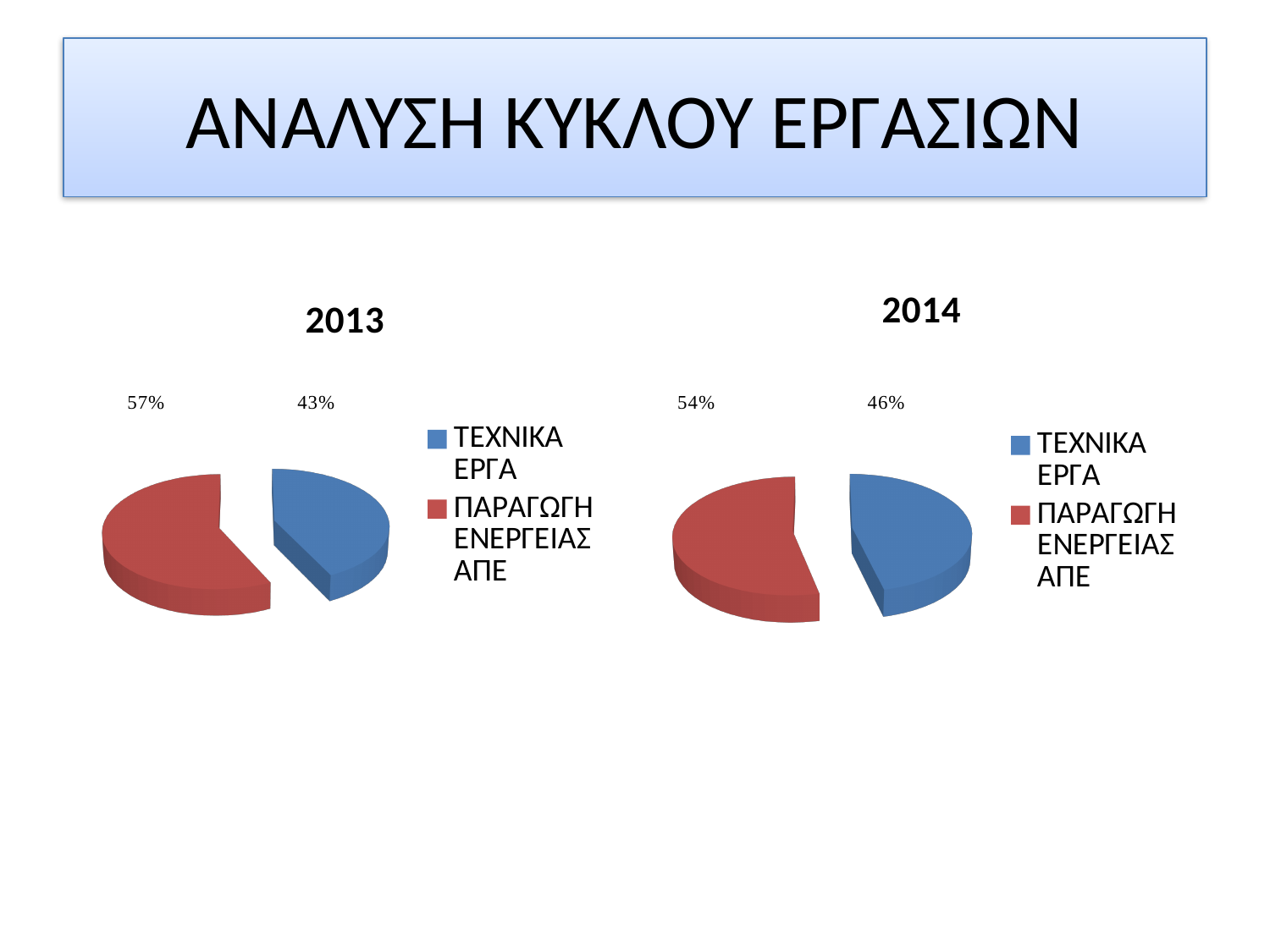
How many categories does the 2014 chart show? 2 In the 2014 chart, what colour is the ΠΑΡΑΓΩΓΗ ΕΝΕΡΓΕΙΑΣ ΑΠΕ slice? Red In the 2013 chart, which category has the largest slice? ΠΑΡΑΓΩΓΗ ΕΝΕΡΓΕΙΑΣ ΑΠΕ In the 2014 chart, which category has the smallest slice? ΤΕΧΝΙΚΑ ΕΡΓΑ In the 2013 chart, what share does ΤΕΧΝΙΚΑ ΕΡΓΑ have? 43% In the 2013 chart, what share does ΠΑΡΑΓΩΓΗ ΕΝΕΡΓΕΙΑΣ ΑΠΕ have? 57% In the 2014 chart, what share does ΠΑΡΑΓΩΓΗ ΕΝΕΡΓΕΙΑΣ ΑΠΕ have? 54% What kind of chart is the 2013 chart? Pie chart In the 2013 chart, what is the difference between the ΠΑΡΑΓΩΓΗ ΕΝΕΡΓΕΙΑΣ ΑΠΕ share and the ΤΕΧΝΙΚΑ ΕΡΓΑ share? 14% In the 2014 chart, what is the difference between the ΠΑΡΑΓΩΓΗ ΕΝΕΡΓΕΙΑΣ ΑΠΕ share and the ΤΕΧΝΙΚΑ ΕΡΓΑ share? 8% Is the ΤΕΧΝΙΚΑ ΕΡΓΑ share larger in the 2013 chart or the 2014 chart? 2014